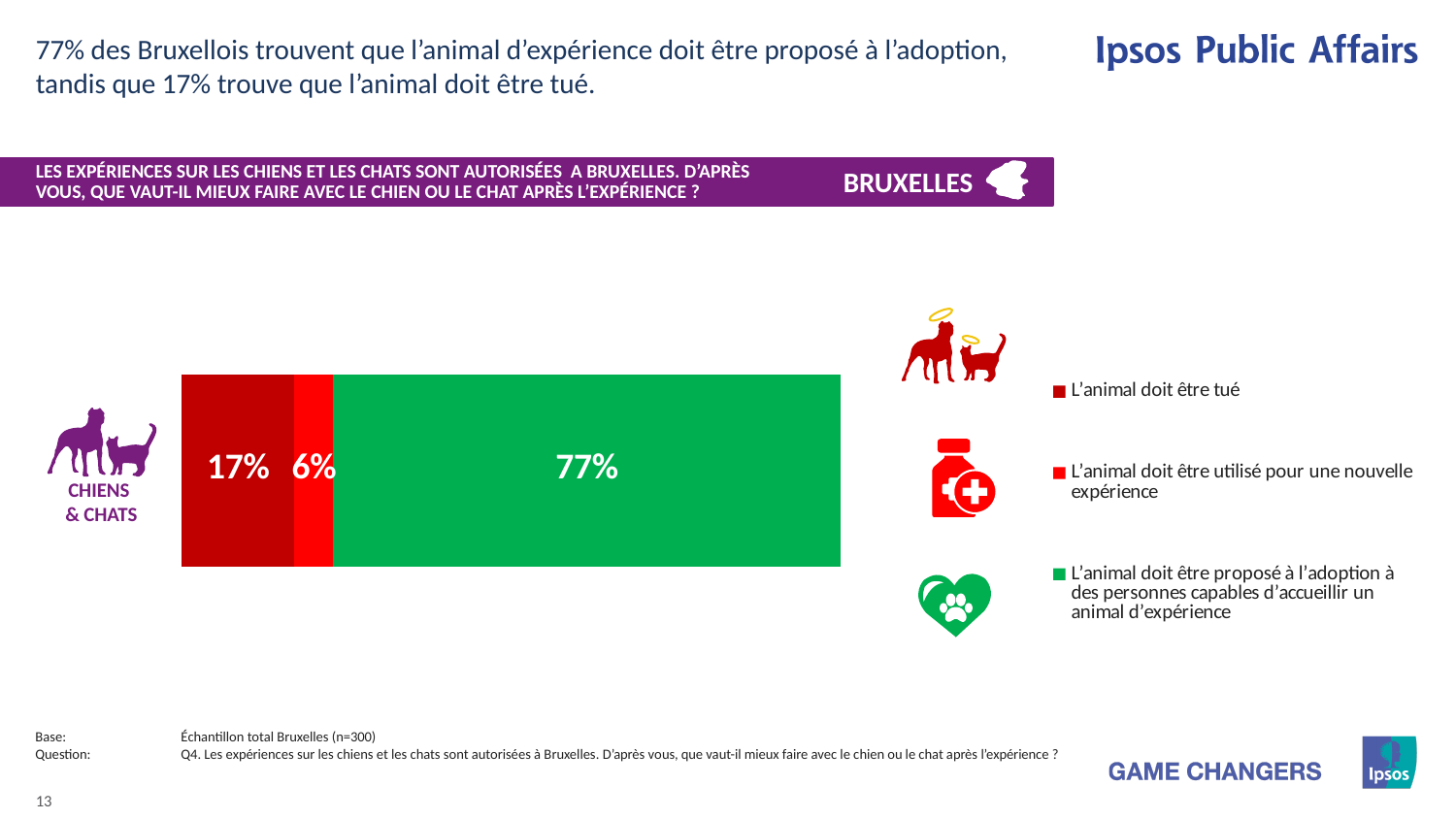
What percentage of respondents say the animal should be killed (L'animal doit être tué)? 17% What is the total of the three segments in the stacked bar? 100% What kind of chart is shown on the slide? Stacked bar chart What percentage of respondents say the animal should be used for a new experiment (L'animal doit être utilisé pour une nouvelle expérience)? 6% Which is larger: the share for 'L'animal doit être tué' or the share for 'L'animal doit être utilisé pour une nouvelle expérience'? L'animal doit être tué What is the difference in percentage points between 'L'animal doit être proposé à l'adoption' and 'L'animal doit être tué'? 60 Which response option has the lowest share in the bar? L'animal doit être utilisé pour une nouvelle expérience What is the difference in percentage points between 'L'animal doit être tué' and 'L'animal doit être utilisé pour une nouvelle expérience'? 11 What colour is the segment for 'L'animal doit être proposé à l'adoption'? Green How many series does the legend list? 3 What percentage of respondents say the animal should be offered for adoption (L'animal doit être proposé à l'adoption)? 77% Which response option has the highest share in the bar? L'animal doit être proposé à l'adoption à des personnes capables d'accueillir un animal d'expérience